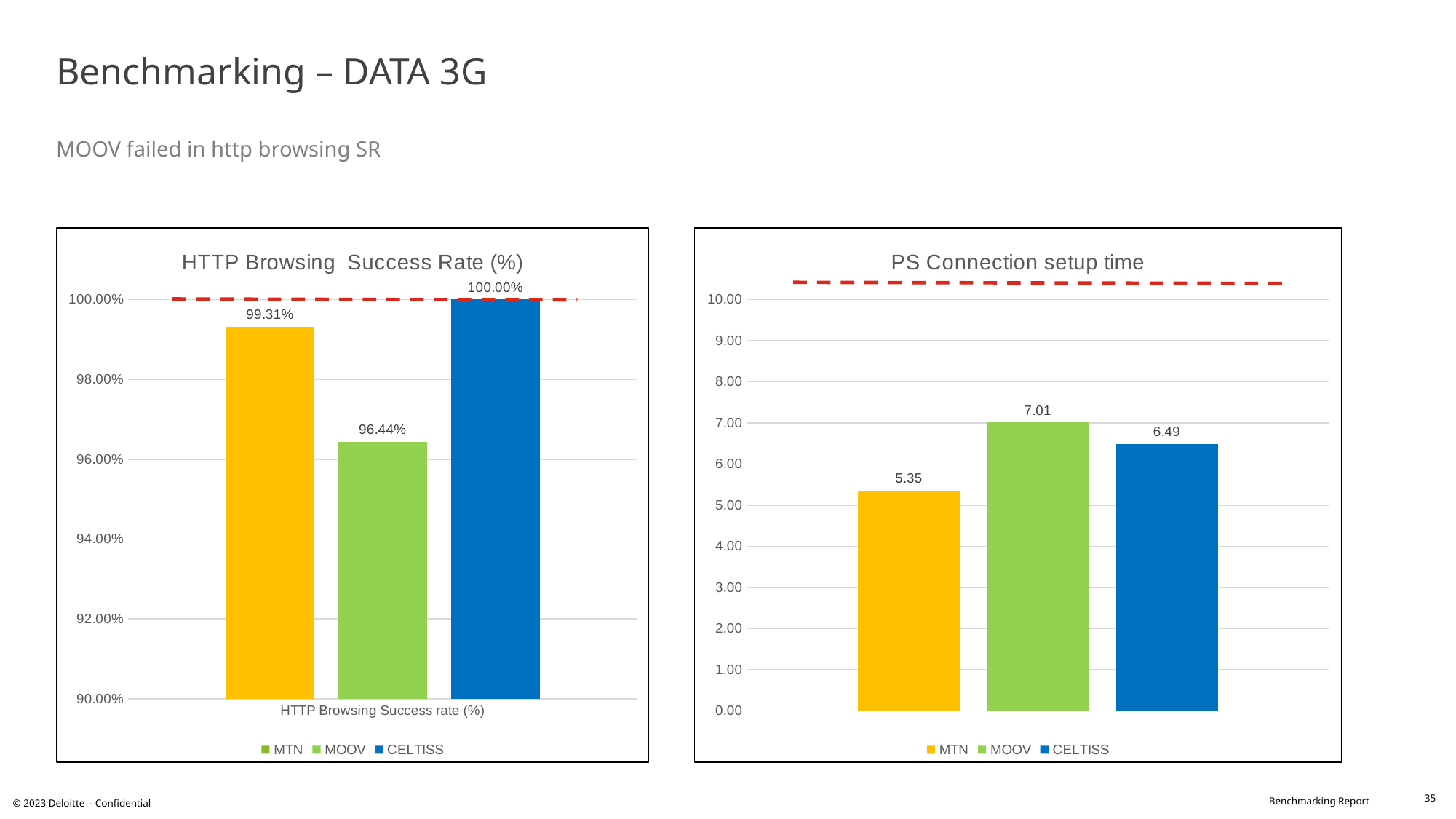
In the HTTP Browsing Success Rate (%) chart, which operator has the highest success rate? CELTISS In the HTTP Browsing Success Rate (%) chart, what is the value for MOOV? 96.44% In the HTTP Browsing Success Rate (%) chart, what is the difference between the CELTISS and MOOV values? 3.56% In the PS Connection setup time chart, is the value for MOOV greater or less than 7.00? greater In the PS Connection setup time chart, what is the value for MTN? 5.35 In the PS Connection setup time chart, which operator has the highest setup time? MOOV In the HTTP Browsing Success Rate (%) chart, which operator has the lowest success rate? MOOV In the HTTP Browsing Success Rate (%) chart, what is the value for MTN? 99.31% What kind of chart is the HTTP Browsing Success Rate (%) chart? Bar chart How many series does the legend of the PS Connection setup time chart list? 3 In the PS Connection setup time chart, what is the value for CELTISS? 6.49 In the PS Connection setup time chart, what is the difference between the MOOV and MTN values? 1.66